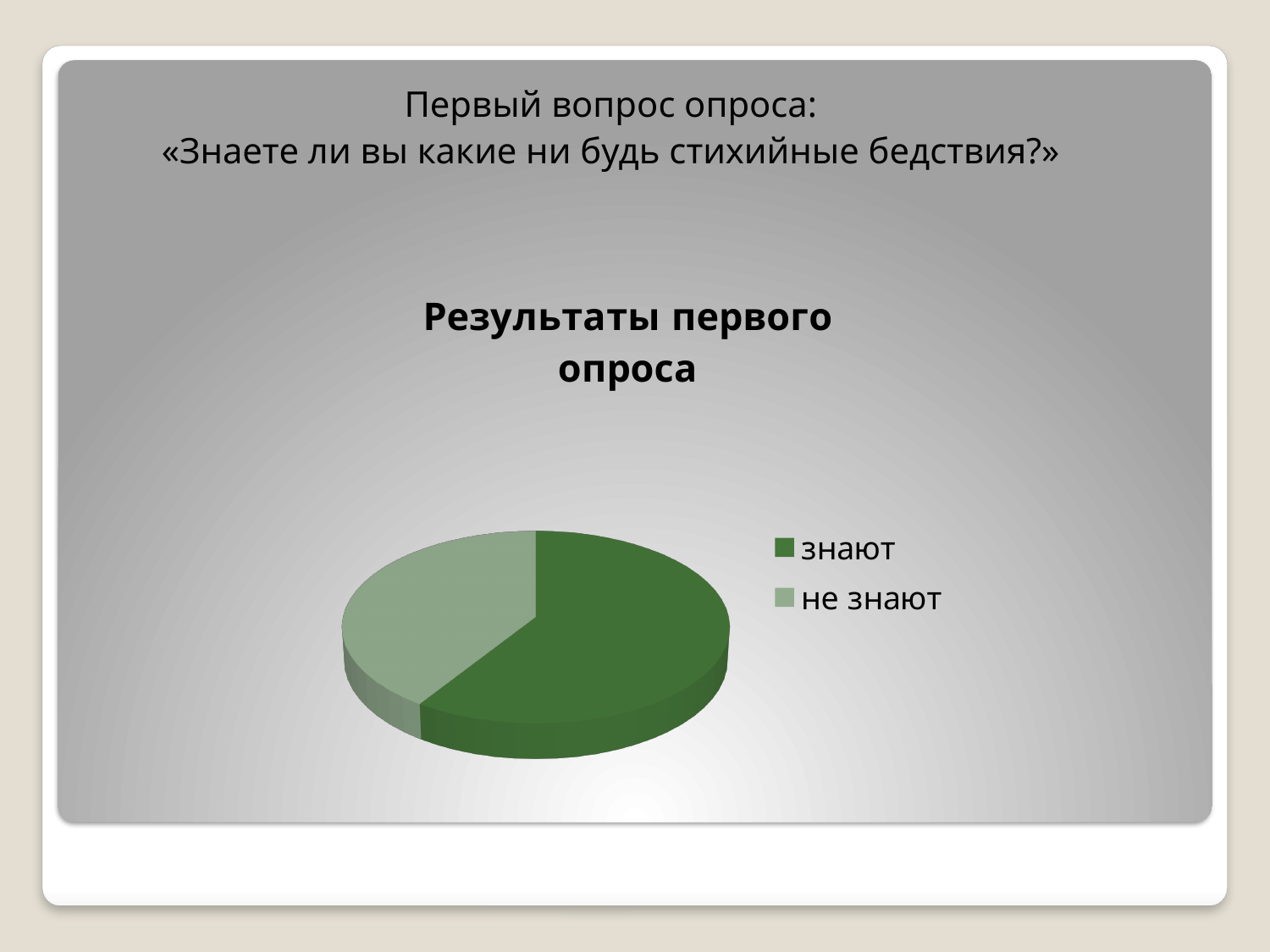
Which category has the largest slice of the pie? знают Which slice is larger, "знают" or "не знают"? знают How many entries does the chart legend list? 2 Which category is shown in the darker green colour? знают Does the "знают" slice take up more or less than half of the pie? more What is the title of the chart? Результаты первого опроса What kind of chart is shown on the slide? pie chart Which category has the smallest slice of the pie? не знают How many slices does the pie chart have? 2